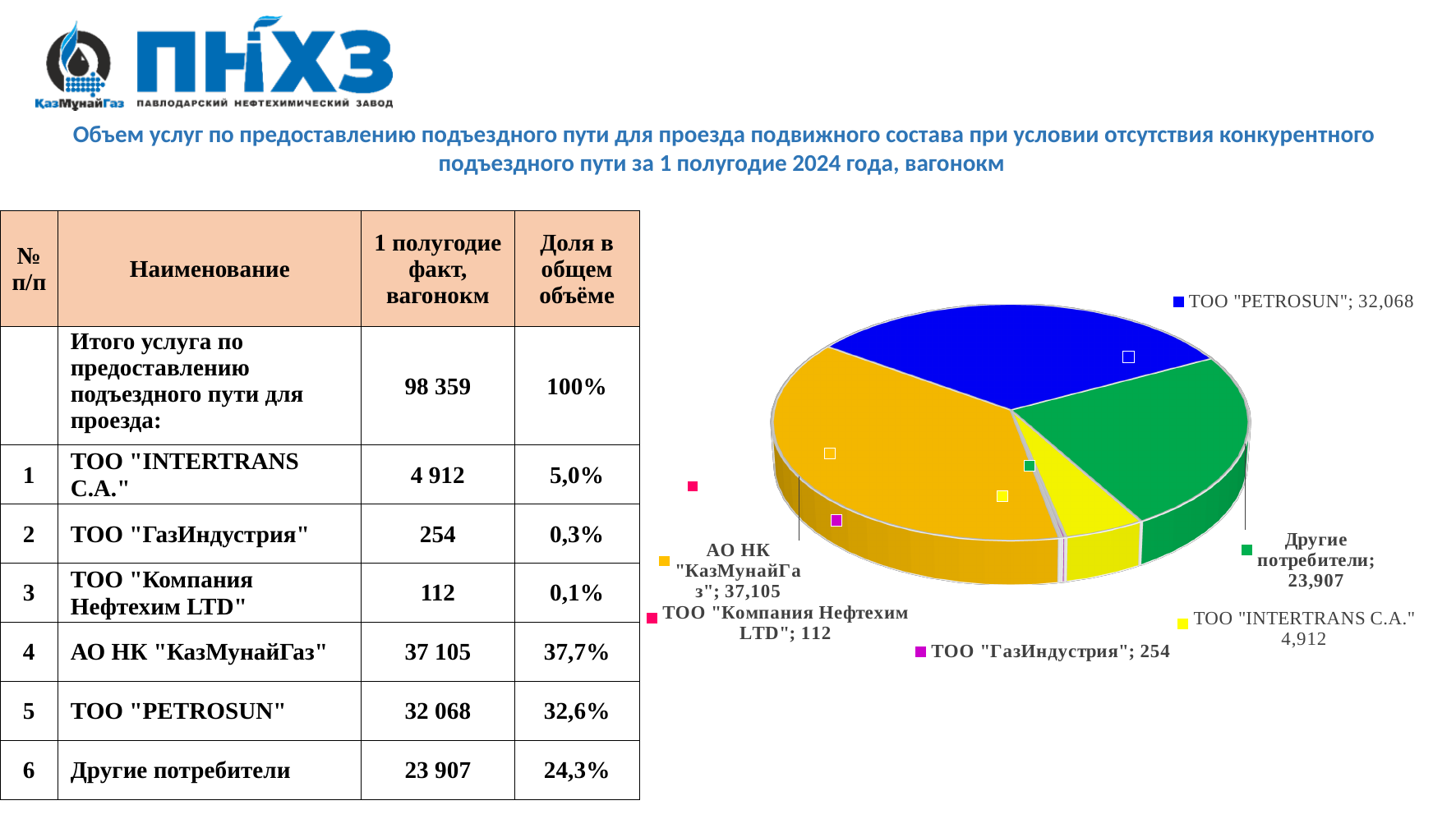
How many slices does the pie chart have? 6 What colour is the slice for ТОО "PETROSUN" in the pie chart? Blue What is the value shown for Другие потребители in the pie chart? 23,907 What colour is the slice for Другие потребители in the pie chart? Green Which category has the largest slice in the pie chart? АО НК "КазМунайГаз" Which is larger in the pie chart: ТОО "INTERTRANS C.A." or Другие потребители? Другие потребители What kind of chart is shown on the slide? Pie chart What is the value shown for АО НК "КазМунайГаз" in the pie chart? 37,105 What is the difference between the values for АО НК "КазМунайГаз" and ТОО "PETROSUN" in the pie chart? 5,037 Which category has the smallest slice in the pie chart? ТОО "Компания Нефтехим LTD" What is the value shown for ТОО "PETROSUN" in the pie chart? 32,068 What is the value shown for ТОО "ГазИндустрия" in the pie chart? 254